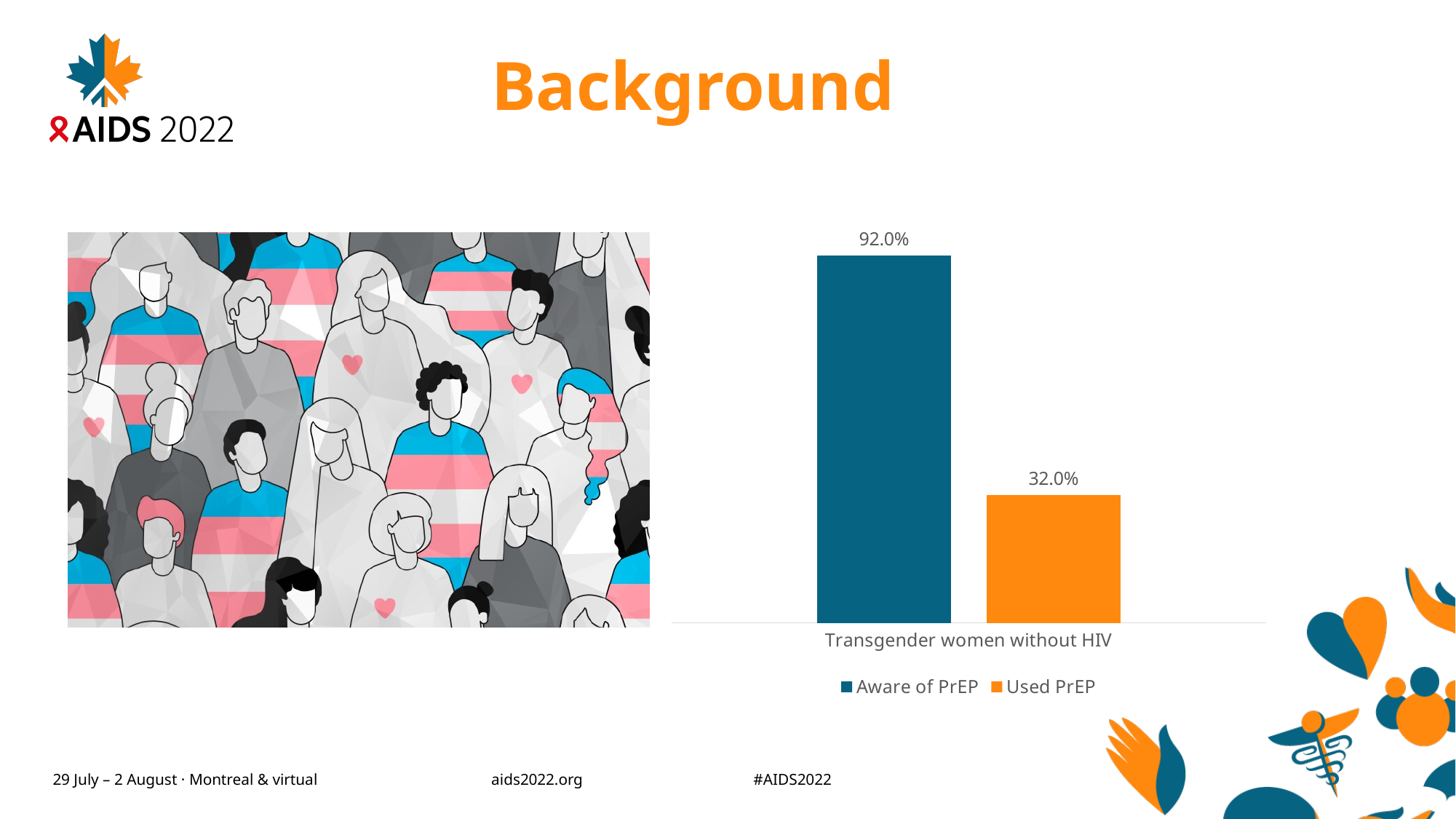
What is the category label on the x axis of the chart? Transgender women without HIV How many series does the legend list? 2 What is the value for Aware of PrEP among transgender women without HIV? 92.0% What is the value for Used PrEP among transgender women without HIV? 32.0% What colour is the bar for Used PrEP? Orange Which series has the lowest value on the chart? Used PrEP Which series has the higher value, Aware of PrEP or Used PrEP? Aware of PrEP What is the difference between the Aware of PrEP and Used PrEP values? 60.0% What kind of chart is shown on the slide? Bar chart How many categories are shown on the x axis? 1